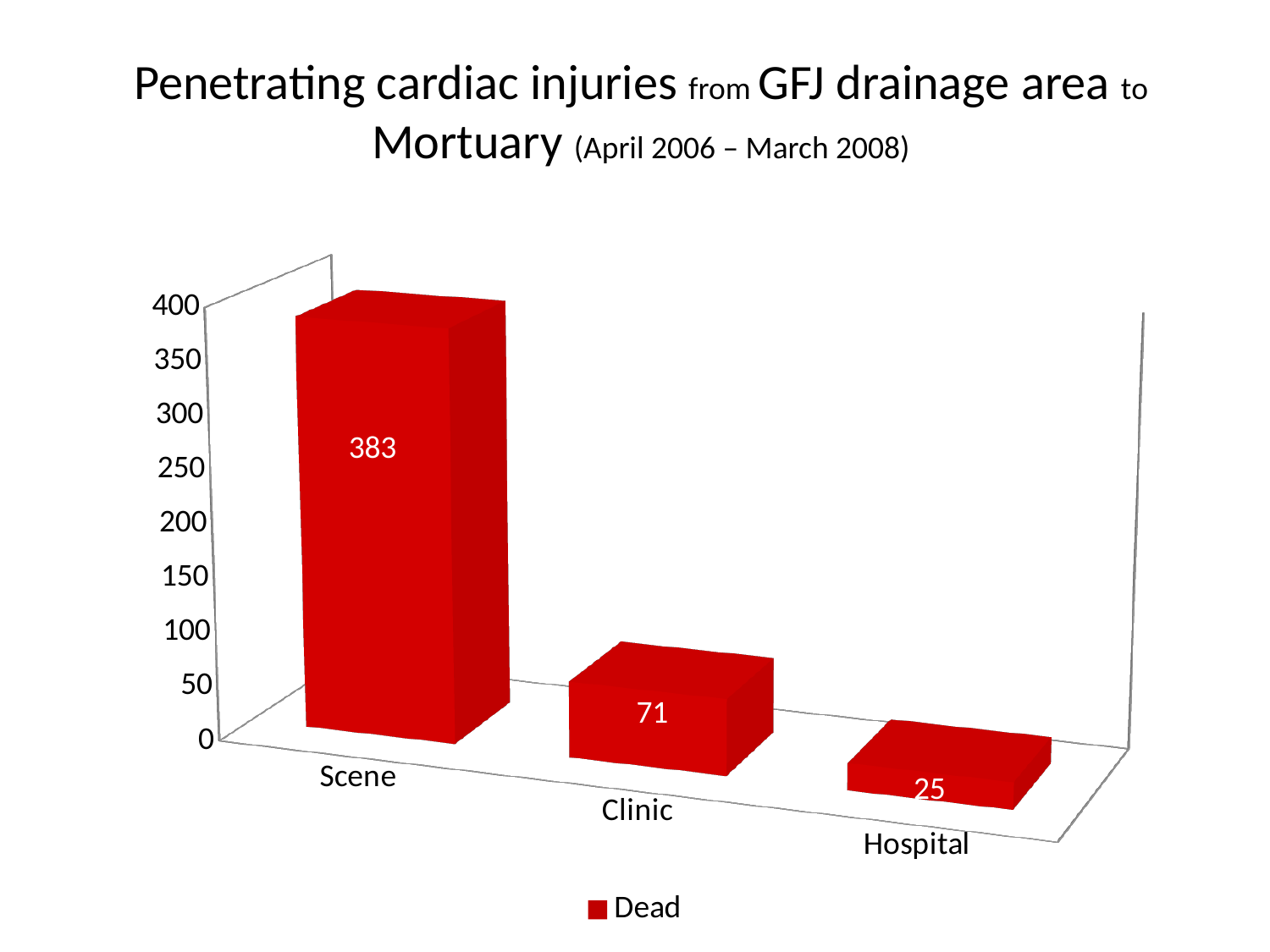
What is the value for Clinic? 71 Which is larger, the value for Clinic or the value for Hospital? Clinic What is the difference between the values for Clinic and Hospital? 46 Which category has the highest value? Scene Which category has the lowest value? Hospital What is the value for Scene? 383 What kind of chart is shown? bar chart How many categories are shown on the x axis? 3 What is the value for Hospital? 25 Is the value for Scene greater or less than 350? greater How many series does the legend list? 1 What is the difference between the values for Scene and Clinic? 312